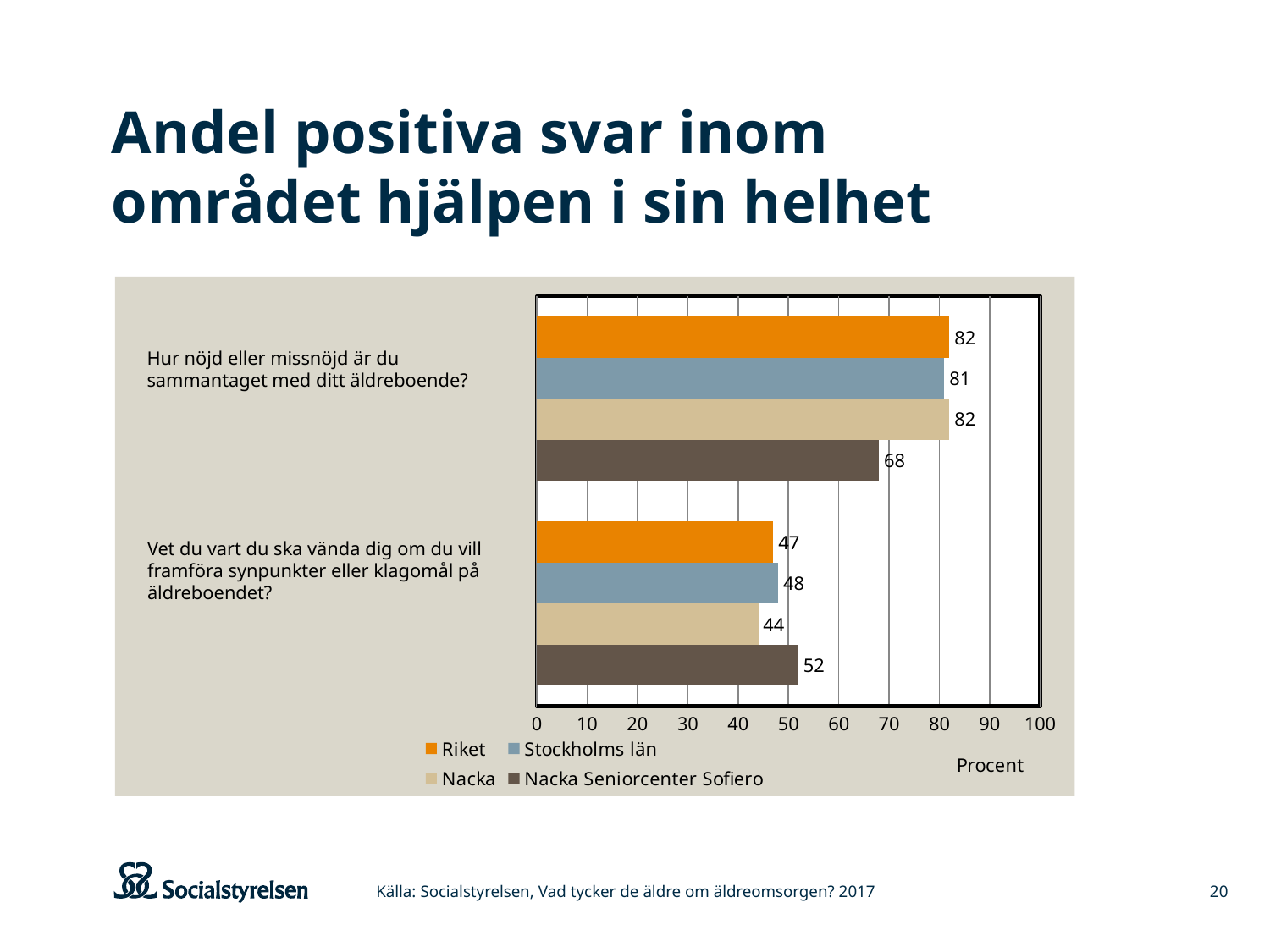
What is the difference between the Riket value and the Nacka Seniorcenter Sofiero value on the question "Hur nöjd eller missnöjd är du sammantaget med ditt äldreboende?"? 14 What is the value for Riket on the question "Vet du vart du ska vända dig om du vill framföra synpunkter eller klagomål på äldreboendet?"? 47 Which series has the lowest value on the question "Hur nöjd eller missnöjd är du sammantaget med ditt äldreboende?"? Nacka Seniorcenter Sofiero What is the label on the horizontal axis of the chart? Procent What is the value for Nacka Seniorcenter Sofiero on the question "Hur nöjd eller missnöjd är du sammantaget med ditt äldreboende?"? 68 Which series has the highest value on the question "Vet du vart du ska vända dig om du vill framföra synpunkter eller klagomål på äldreboendet?"? Nacka Seniorcenter Sofiero What is the value for Nacka on the question "Vet du vart du ska vända dig om du vill framföra synpunkter eller klagomål på äldreboendet?"? 44 How many series does the legend list? 4 What kind of chart is shown on the slide? Bar chart How many questions (categories) are shown on the chart? 2 What is the value for Stockholms län on the question "Hur nöjd eller missnöjd är du sammantaget med ditt äldreboende?"? 81 On the question "Vet du vart du ska vända dig om du vill framföra synpunkter eller klagomål på äldreboendet?", which is larger: the value for Nacka or the value for Nacka Seniorcenter Sofiero? Nacka Seniorcenter Sofiero